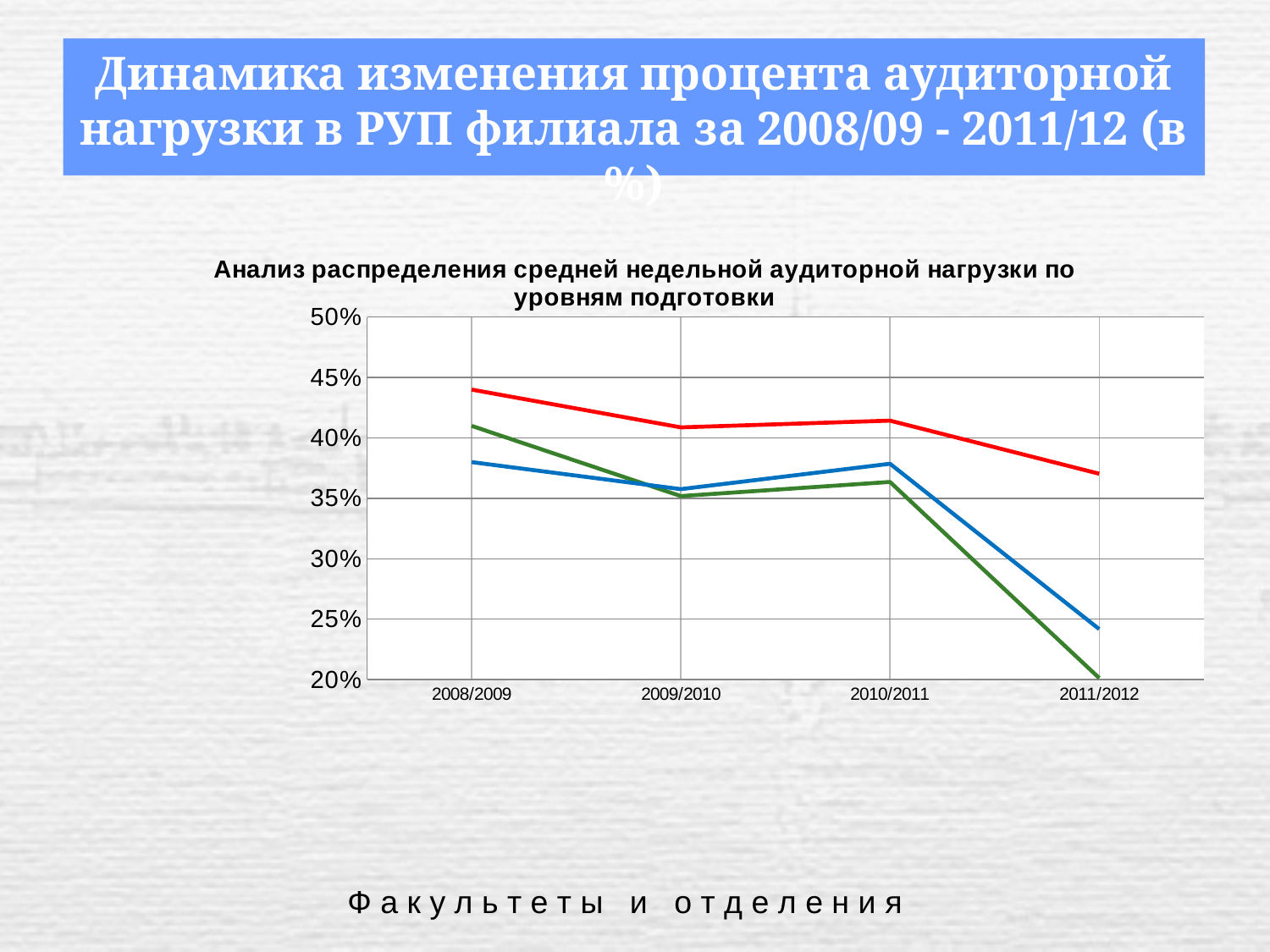
In which academic year does the red line reach its highest value? 2008/2009 Is the value of the red line for 2011/2012 greater or less than 35%? greater Is the value of the red line for 2008/2009 greater or less than 40%? greater How many academic years are shown on the x axis of the chart? 4 How many lines are plotted on the chart? 3 What is the title printed above the chart? Анализ распределения средней недельной аудиторной нагрузки по уровням подготовки Is the value of the green line for 2011/2012 greater or less than 25%? less Which line has the higher value for 2008/2009, the green line or the blue line? green line Which line has the higher value for 2011/2012, the red line or the green line? red line Does the green line rise or fall from 2010/2011 to 2011/2012? fall What kind of chart is shown on the slide? line chart